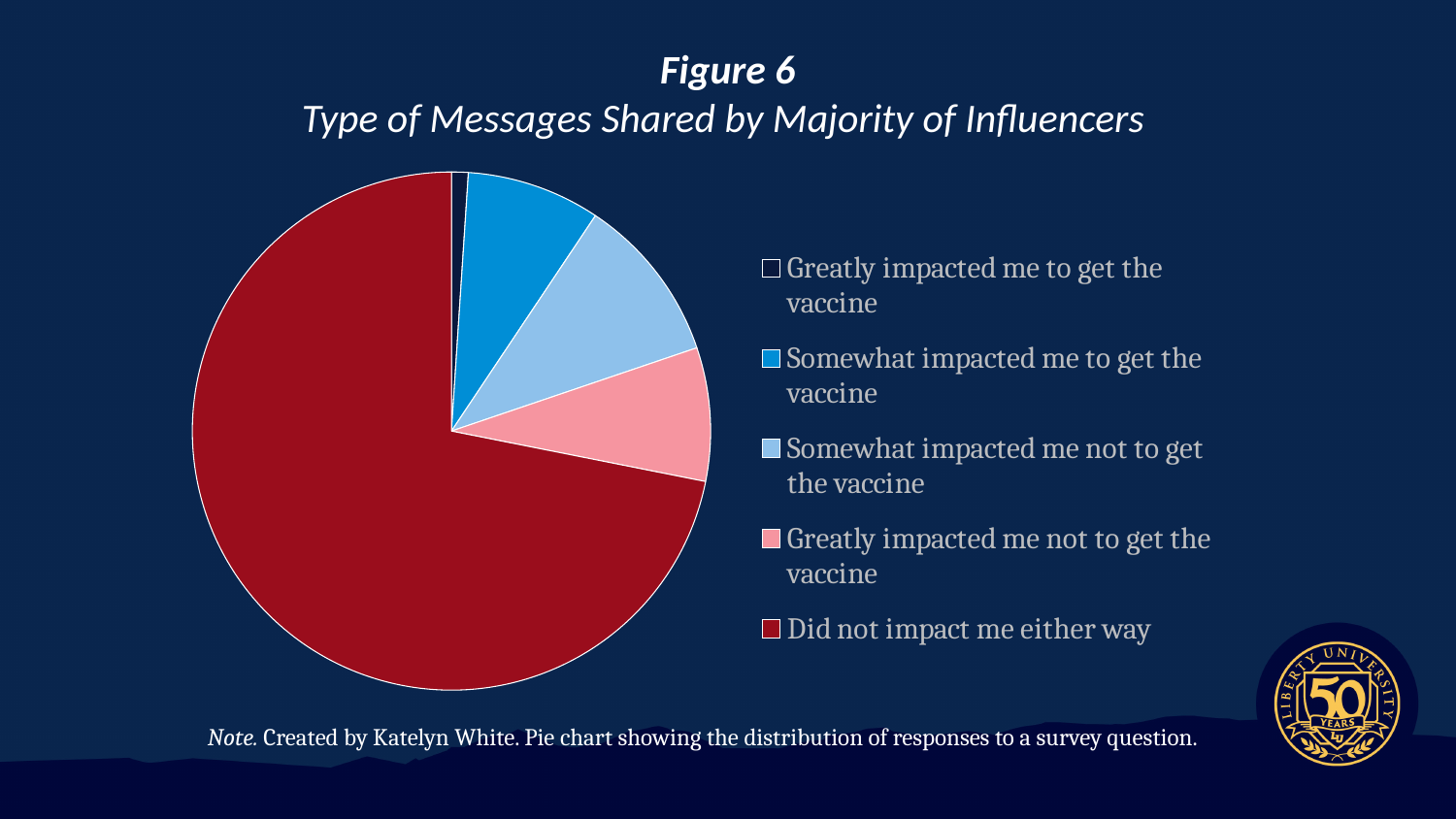
Which category has the largest slice of the pie? Did not impact me either way Which slice is larger: "Greatly impacted me to get the vaccine" or "Somewhat impacted me to get the vaccine"? Somewhat impacted me to get the vaccine How many entries does the legend list? 5 What kind of chart is shown on the slide? pie chart How many categories does the pie chart have? 5 Which slice is larger: "Somewhat impacted me to get the vaccine" or "Somewhat impacted me not to get the vaccine"? Somewhat impacted me not to get the vaccine What colour is the slice for "Did not impact me either way"? dark red What is the title of the chart shown as Figure 6? Type of Messages Shared by Majority of Influencers Which category has the smallest slice of the pie? Greatly impacted me to get the vaccine Which slice is larger: "Did not impact me either way" or "Greatly impacted me not to get the vaccine"? Did not impact me either way